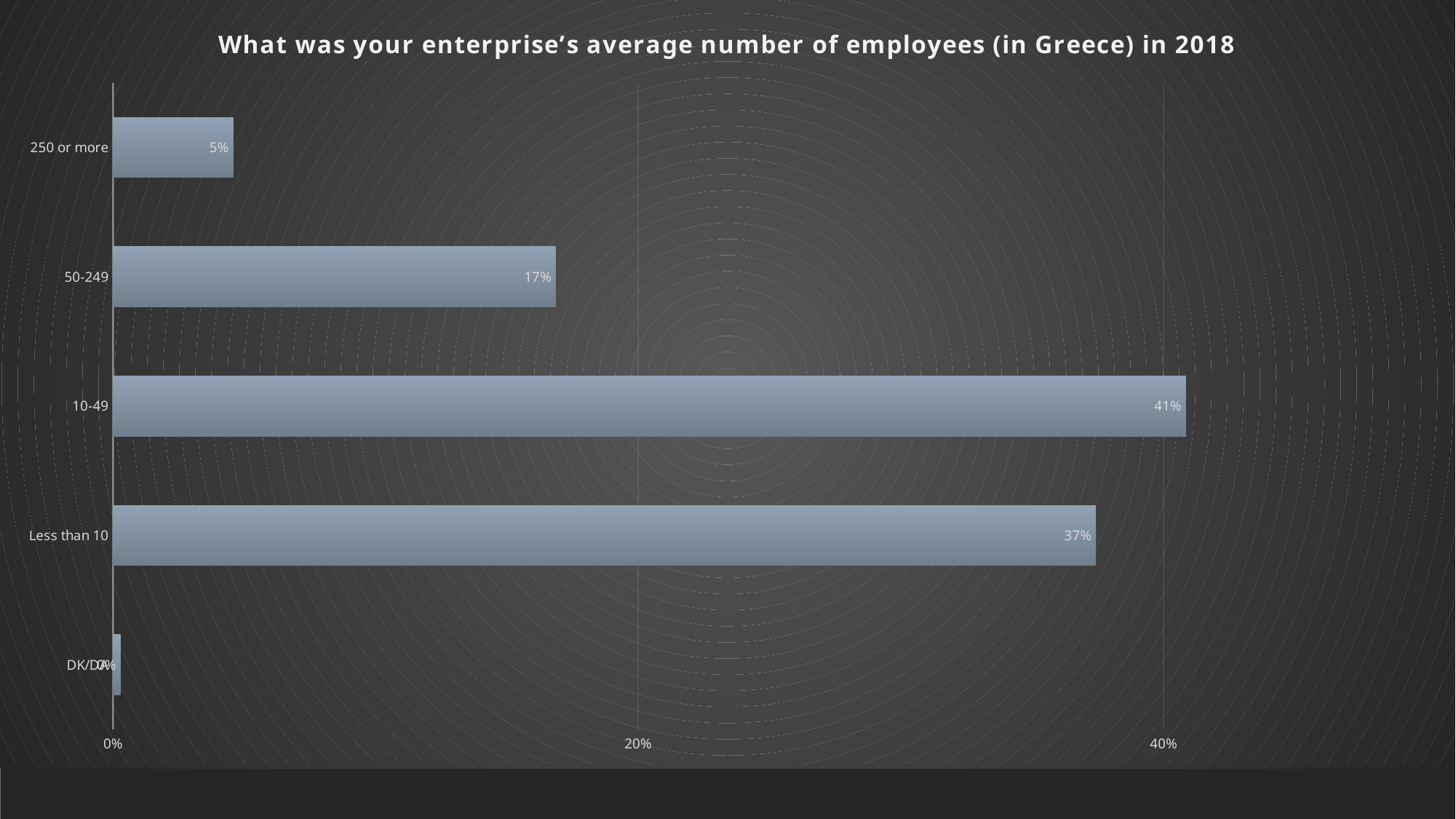
What percentage of enterprises reported 10-49 employees? 41% Which employee-size category has the lowest percentage? DK/DA What is the difference in percentage points between the 50-249 and 250 or more categories? 12% What is the difference in percentage points between the 10-49 and Less than 10 categories? 4% What percentage of enterprises reported 50-249 employees? 17% What percentage of enterprises reported 250 or more employees? 5% What kind of chart is shown on the slide? Bar chart Which employee-size category has the highest percentage? 10-49 What is the title of the chart? What was your enterprise's average number of employees (in Greece) in 2018 How many categories are shown on the chart? 5 What percentage of enterprises reported less than 10 employees? 37% Which is larger, the value for 50-249 or the value for 250 or more? 50-249